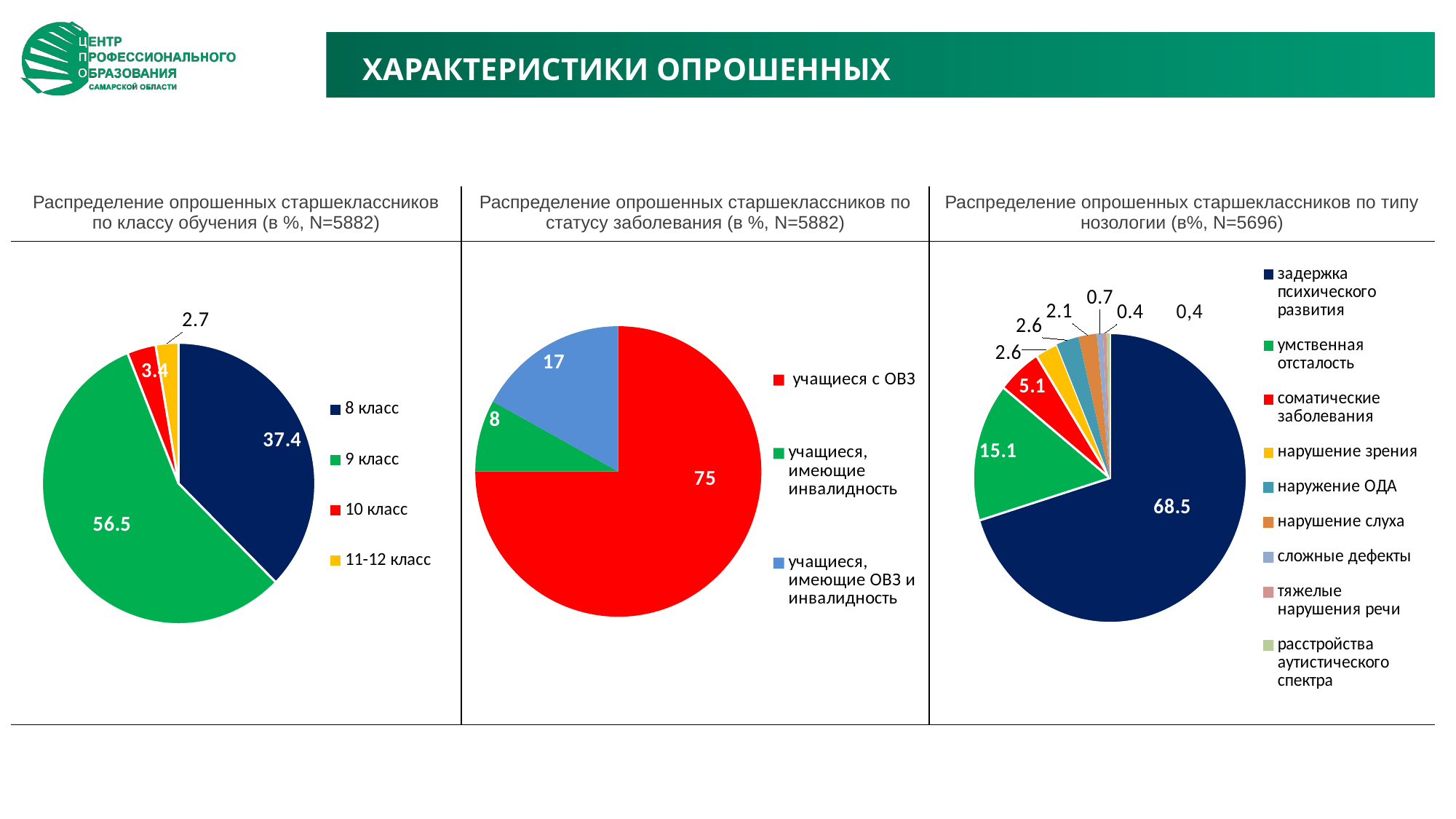
In the right chart (by type of nosology), how many categories does the legend list? 9 In the left chart (by class of study), what percentage of respondents are in 8 класс? 37.4 In the middle chart (by disease status), what is the share of учащиеся с ОВЗ? 75 In the right chart (by type of nosology), what is the share of задержка психического развития? 68.5 In the left chart (by class of study), which class has the smallest share? 11-12 класс In the left chart (by class of study), what is the difference between the shares of 9 класс and 8 класс? 19.1 In the middle chart (by disease status), how many categories does the legend list? 3 What type of chart is used in the middle chart (by disease status)? pie chart In the left chart (by class of study), what percentage of respondents are in 9 класс? 56.5 In the middle chart (by disease status), which category has the smallest share? учащиеся, имеющие инвалидность In the right chart (by type of nosology), what is the share of умственная отсталость? 15.1 In the right chart (by type of nosology), which is larger: соматические заболевания or умственная отсталость? умственная отсталость